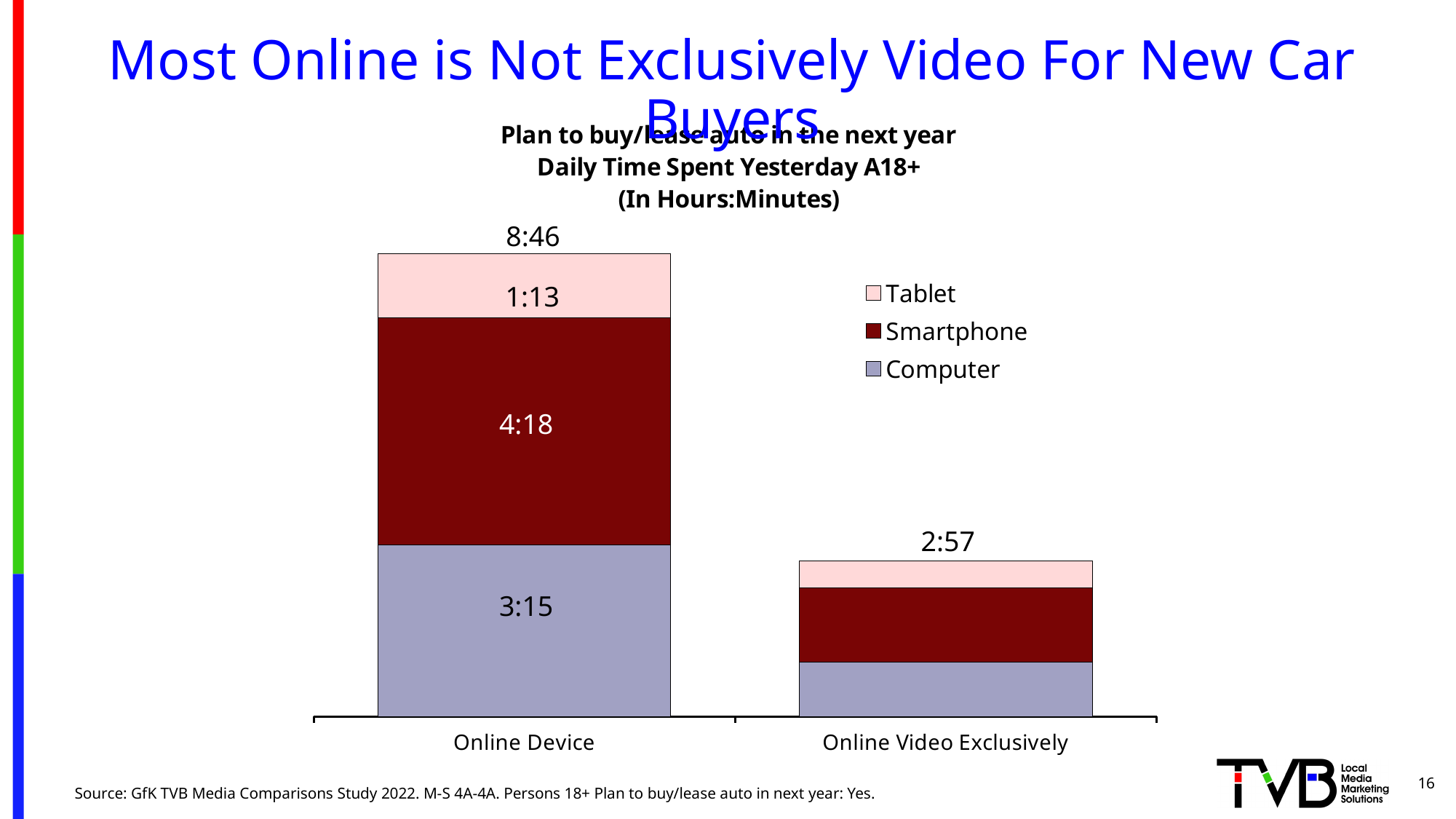
What is the Tablet value for Online Device? 1:13 What is the total daily time spent for Online Device? 8:46 What is the total daily time spent for Online Video Exclusively? 2:57 What type of chart is shown on the slide? Stacked bar chart What is the Smartphone value for Online Device? 4:18 What is the difference between the Smartphone and Computer values for Online Device? 1:03 How many categories are shown on the x axis of the chart? 2 What is the Computer value for Online Device? 3:15 Which category has the higher total daily time spent, Online Device or Online Video Exclusively? Online Device Which series is shown in dark red in the chart? Smartphone Within the Online Device bar, which device has the smallest time spent? Tablet How many series does the chart's legend list? 3